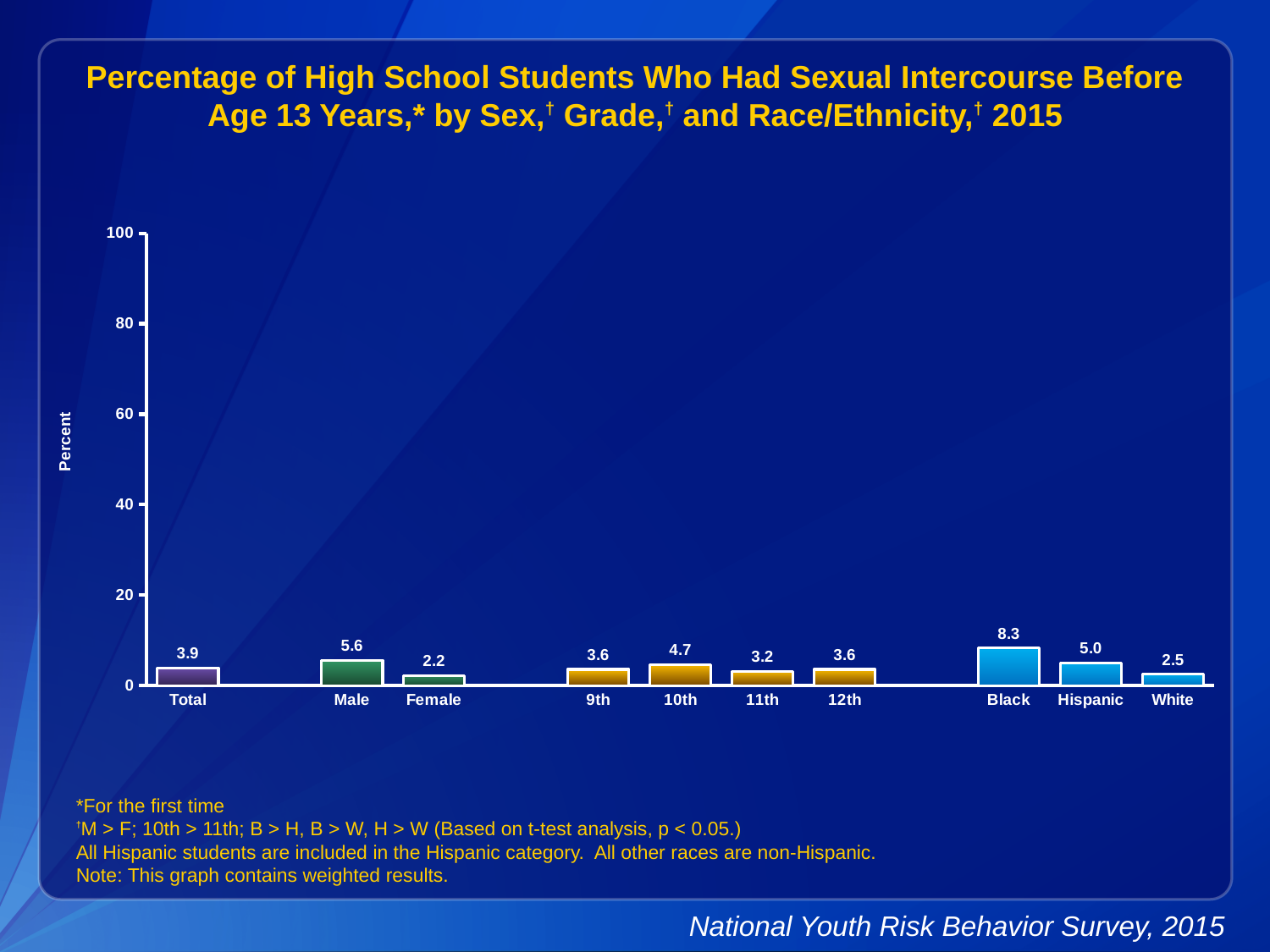
Which category has the highest value? Black What is the difference between the values for Male and Female? 3.4 Is the value for Black greater or less than 20? less How many bars are shown in the chart? 10 What is the value for Total? 3.9 What is the value for Black? 8.3 Which is larger, the value for Hispanic or the value for White? Hispanic Which category has the lowest value? Female What kind of chart is shown on the slide? bar chart What is the value for 10th grade? 4.7 What is the value for Male? 5.6 What is the label on the vertical axis? Percent